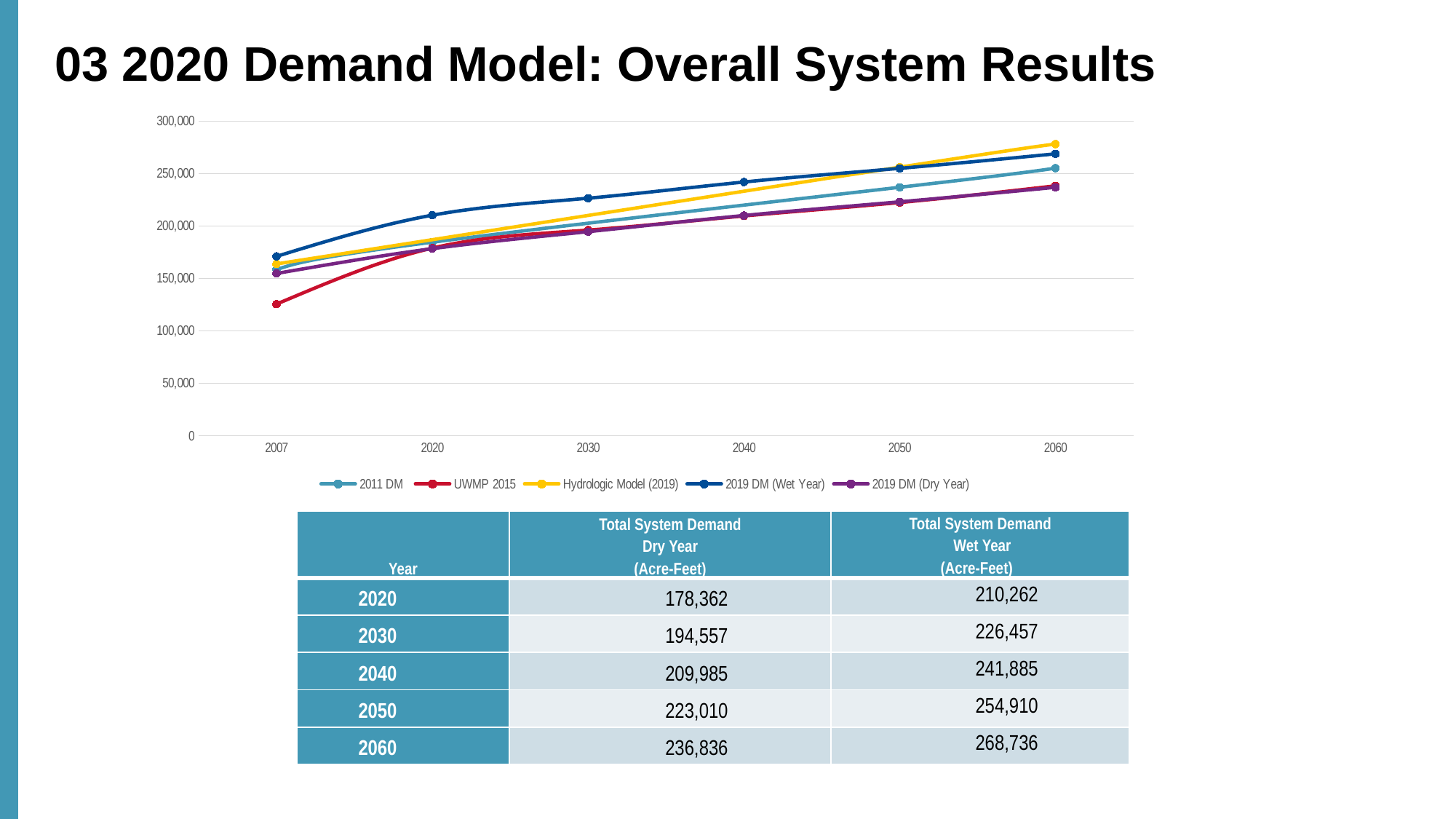
Is the value for UWMP 2015 in 2007 greater or less than 150,000? less According to the table below the chart, what is the difference between the Wet Year and Dry Year Total System Demand in 2060? 31,900 Is the value for 2019 DM (Wet Year) in 2060 greater or less than 250,000? greater Do the values for 2019 DM (Wet Year) rise or fall from 2007 to 2060? rise What kind of chart is shown on the slide? line chart How many years are marked along the x axis of the chart? 6 Which series has the highest value in 2060? Hydrologic Model (2019) Which series has the lowest value in 2007? UWMP 2015 Which series has the highest value in 2007? 2019 DM (Wet Year) How many series does the chart's legend list? 5 According to the table below the chart, what is the Total System Demand for the Dry Year in 2020? 178,362